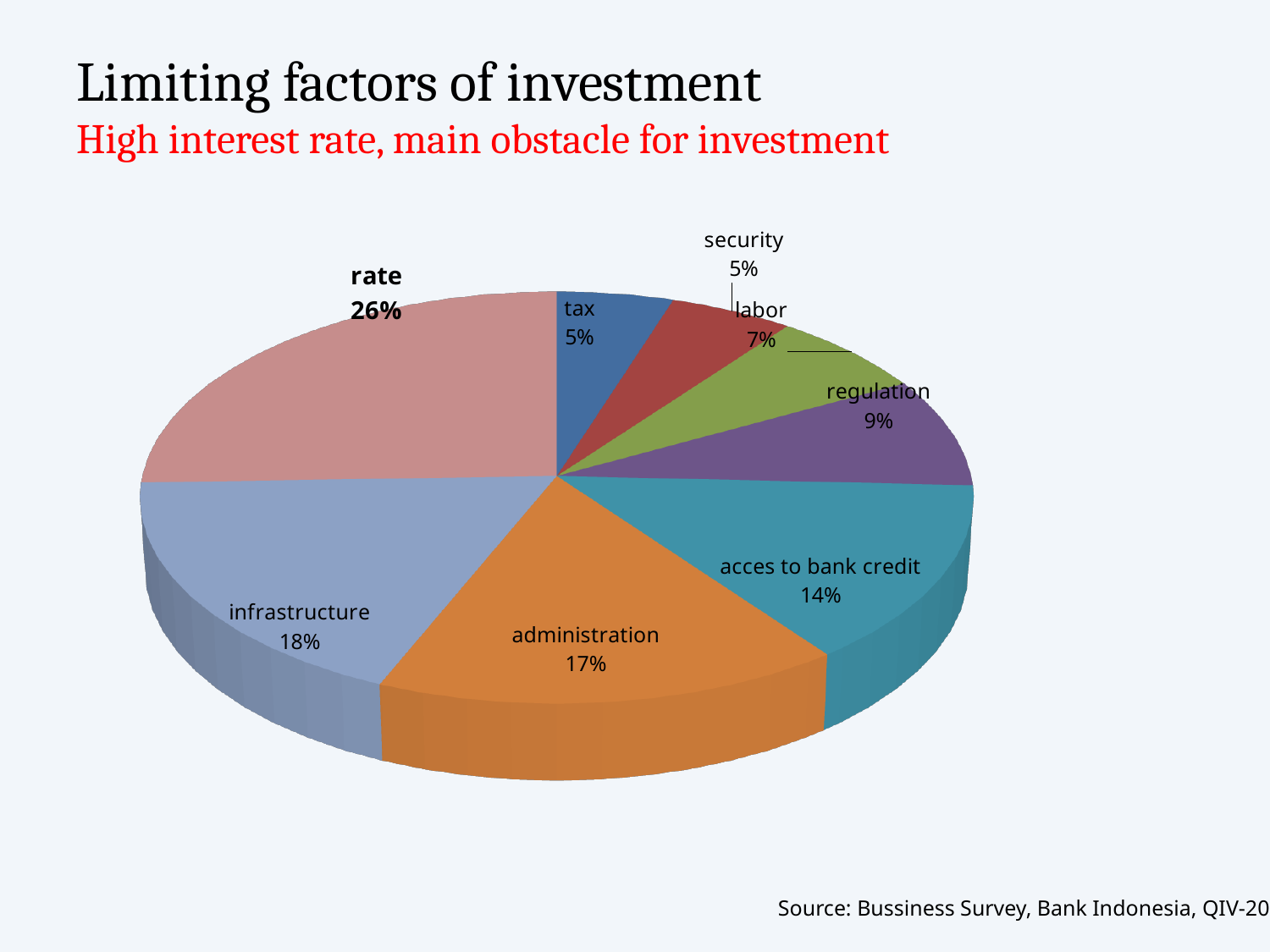
What is the title of the slide containing the chart? Limiting factors of investment What share of the pie does "rate" account for? 26% What is the value shown for "acces to bank credit"? 14% What is the value shown for "labor"? 7% What is the value shown for "regulation"? 9% What kind of chart is shown on the slide? pie chart Which two categories share the smallest value in the pie chart? tax and security What is the difference between the values for "administration" and "labor"? 10% How many categories are shown in the pie chart? 8 What is the value shown for "infrastructure"? 18% Which is larger, the value for "infrastructure" or the value for "administration"? infrastructure Which category has the largest slice of the pie? rate